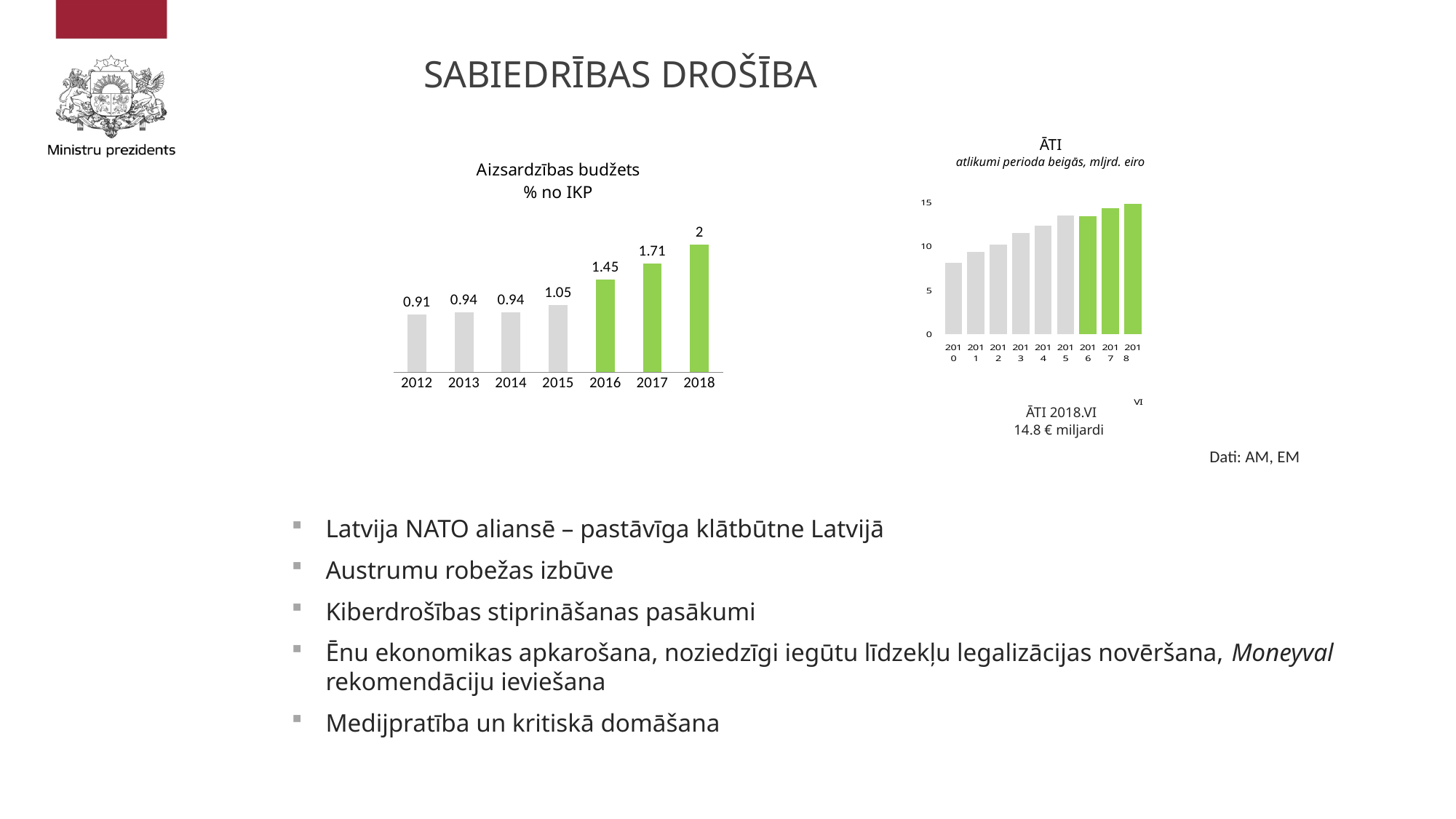
In the 'ĀTI' chart, which year has the lowest value? 2010 What kind of chart is the 'ĀTI' chart? bar chart How many years are shown in the 'Aizsardzības budžets % no IKP' chart? 7 In the 'Aizsardzības budžets % no IKP' chart, what is the value for 2016? 1.45 In the 'Aizsardzības budžets % no IKP' chart, which year has the lowest value? 2012 In the 'Aizsardzības budžets % no IKP' chart, which is larger, the value for 2015 or the value for 2016? 2016 In the 'ĀTI' chart, is the value for 2018 greater or less than 10? greater In the 'Aizsardzības budžets % no IKP' chart, what is the value for 2012? 0.91 In the 'Aizsardzības budžets % no IKP' chart, which year has the highest value? 2018 In the 'ĀTI' chart, do the values rise or fall from 2010 to 2018? rise In the 'Aizsardzības budžets % no IKP' chart, what is the difference between the values for 2018 and 2017? 0.29 In the 'ĀTI' chart, is the value for 2010 greater or less than 10? less